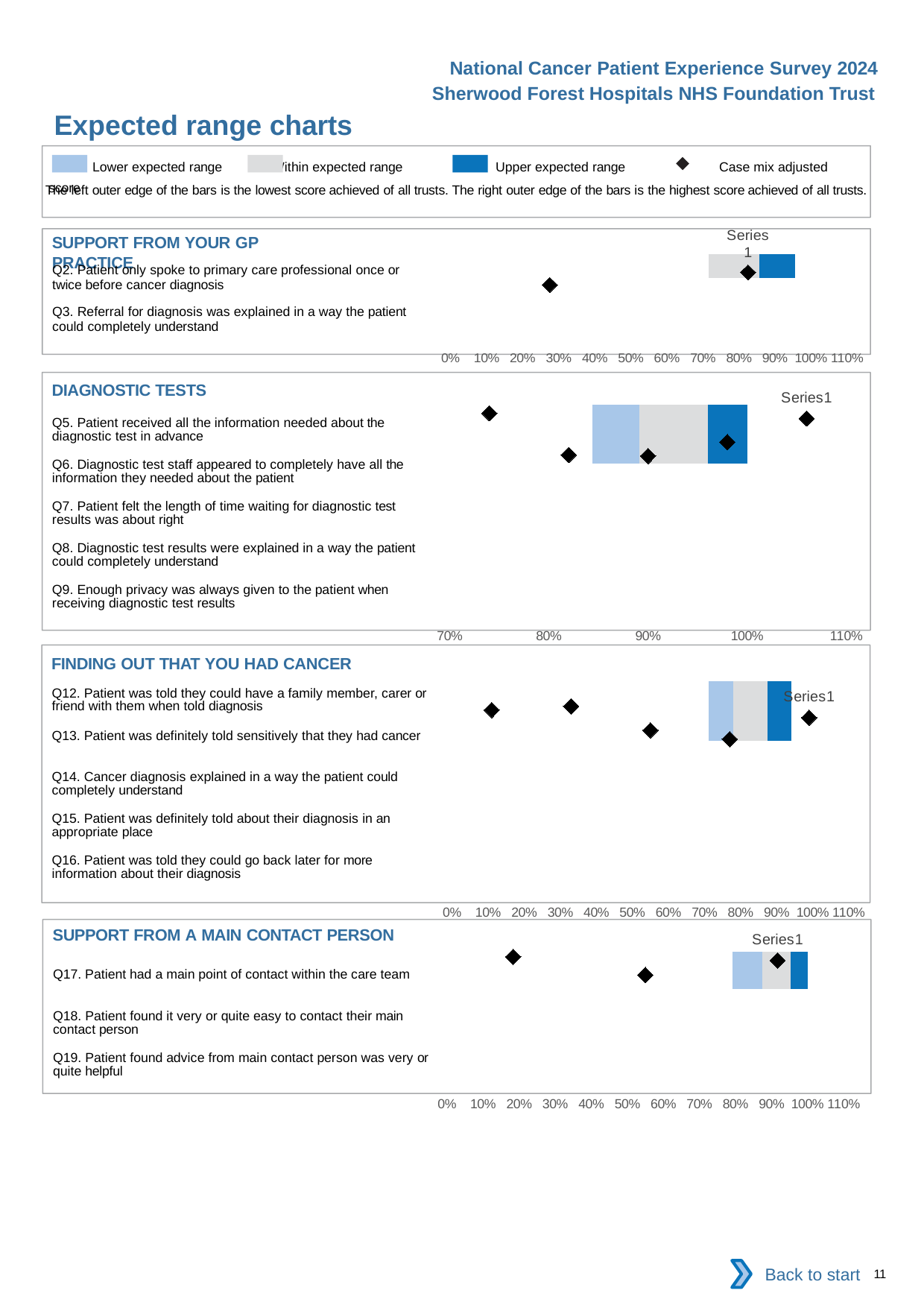
Which colour does the legend use for 'Upper expected range'? dark blue In the 'DIAGNOSTIC TESTS' chart, does the dark blue upper expected range segment start at a value greater or less than 90%? greater How many questions are listed in the 'SUPPORT FROM YOUR GP PRACTICE' chart? 2 How many questions are listed in the 'SUPPORT FROM A MAIN CONTACT PERSON' chart? 3 How many entries does the legend at the top of the slide list? 4 What kind of chart is used in the 'DIAGNOSTIC TESTS' section? bar chart How many questions are listed in the 'DIAGNOSTIC TESTS' chart? 5 In the 'DIAGNOSTIC TESTS' chart, is the left edge of the expected range bar greater or less than 80%? greater What is the lowest value shown on the x axis of the 'DIAGNOSTIC TESTS' chart? 70%